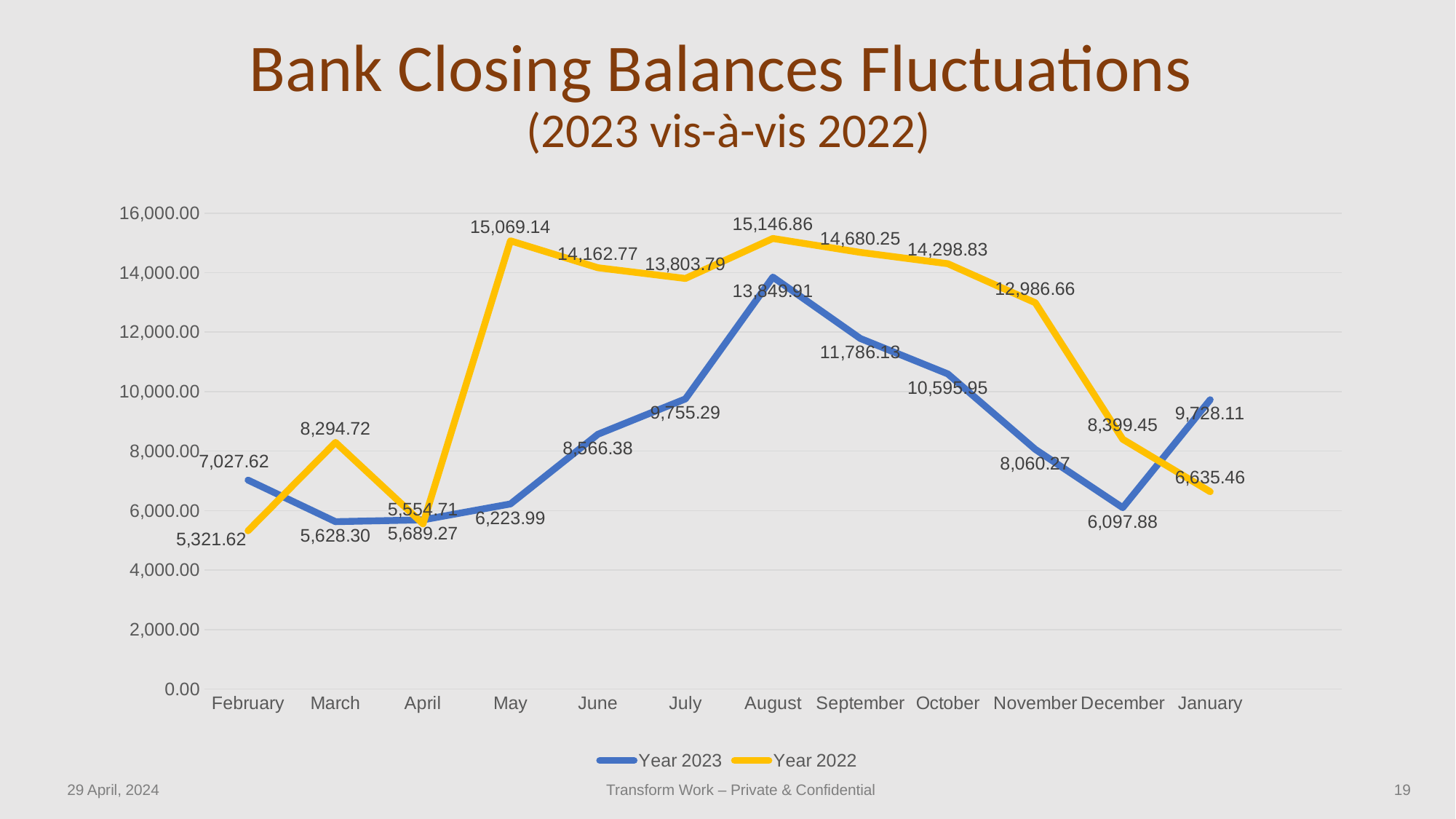
Does the Year 2022 closing balance rise or fall from August to January? fall Is the Year 2022 closing balance for November greater or less than 12,000.00? greater What colour is the Year 2022 line? yellow Which series has the larger closing balance in January, Year 2023 or Year 2022? Year 2023 What is the difference between the Year 2022 and Year 2023 closing balances in August? 1,296.95 In which month is the Year 2022 closing balance highest? August How many months are plotted along the x axis? 12 What is the Year 2022 closing balance for May? 15,069.14 How many series does the legend list? 2 What is the Year 2023 closing balance for August? 13,849.91 In which month is the Year 2023 closing balance lowest? March What kind of chart is shown on the slide? line chart